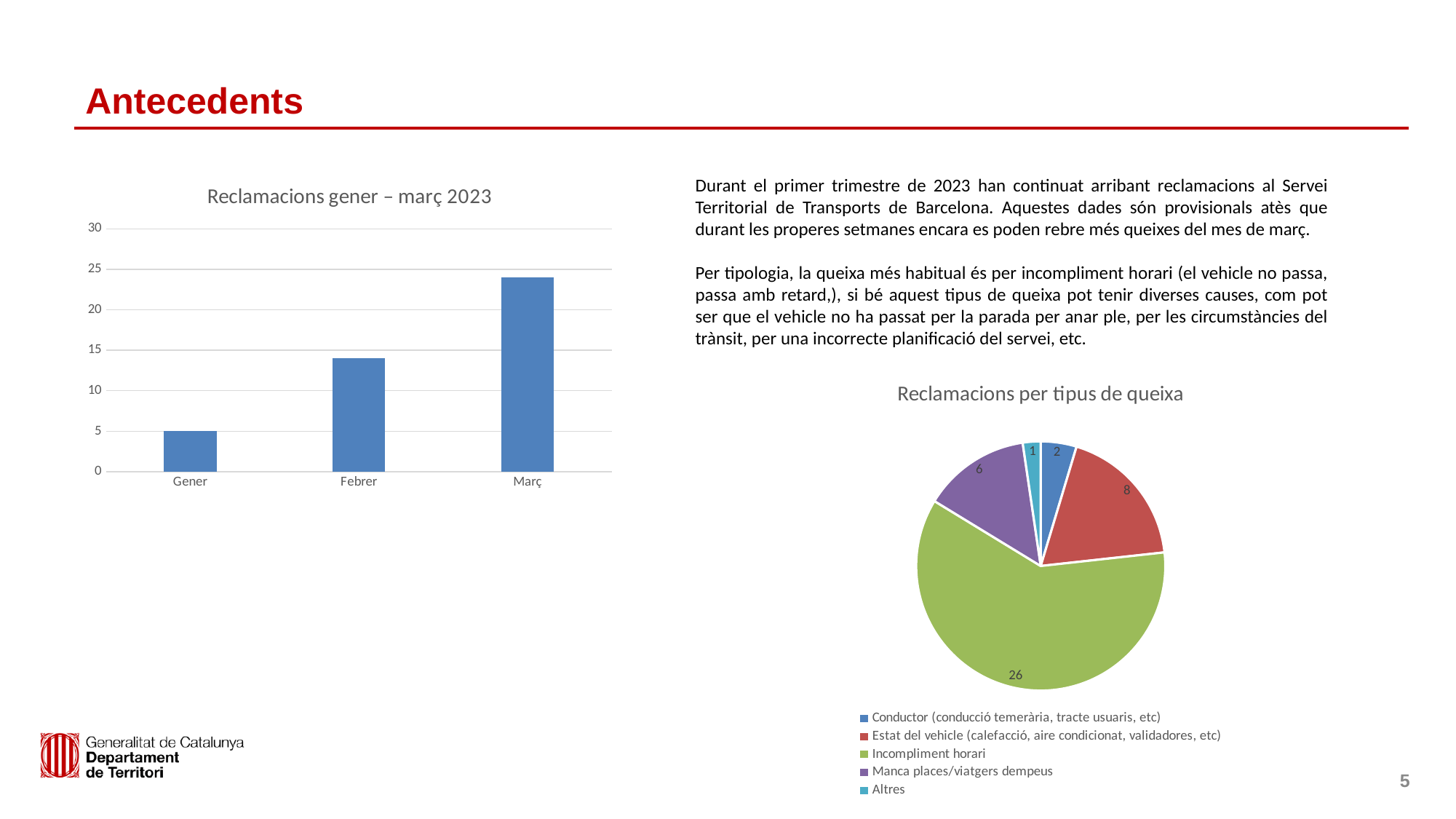
In the bar chart 'Reclamacions gener – març 2023', what is the value for Gener? 5 In the bar chart 'Reclamacions gener – març 2023', how many months are plotted? 3 In the pie chart 'Reclamacions per tipus de queixa', what is the value for Estat del vehicle (calefacció, aire condicionat, validadores, etc)? 8 In the bar chart 'Reclamacions gener – març 2023', which month has the highest number of complaints? Març In the pie chart 'Reclamacions per tipus de queixa', how many categories does the legend list? 5 In the bar chart 'Reclamacions gener – març 2023', is the value for Març greater or less than 25? less In the bar chart 'Reclamacions gener – març 2023', what type of chart is shown? bar chart In the bar chart 'Reclamacions gener – març 2023', which month has the lowest number of complaints? Gener In the pie chart 'Reclamacions per tipus de queixa', what is the difference between Manca places/viatgers dempeus and Conductor (conducció temerària, tracte usuaris, etc)? 4 In the bar chart 'Reclamacions gener – març 2023', is the value for Febrer greater or less than 10? greater In the bar chart 'Reclamacions gener – març 2023', do the values rise or fall from Gener to Març? rise In the pie chart 'Reclamacions per tipus de queixa', what is the value for Incompliment horari? 26